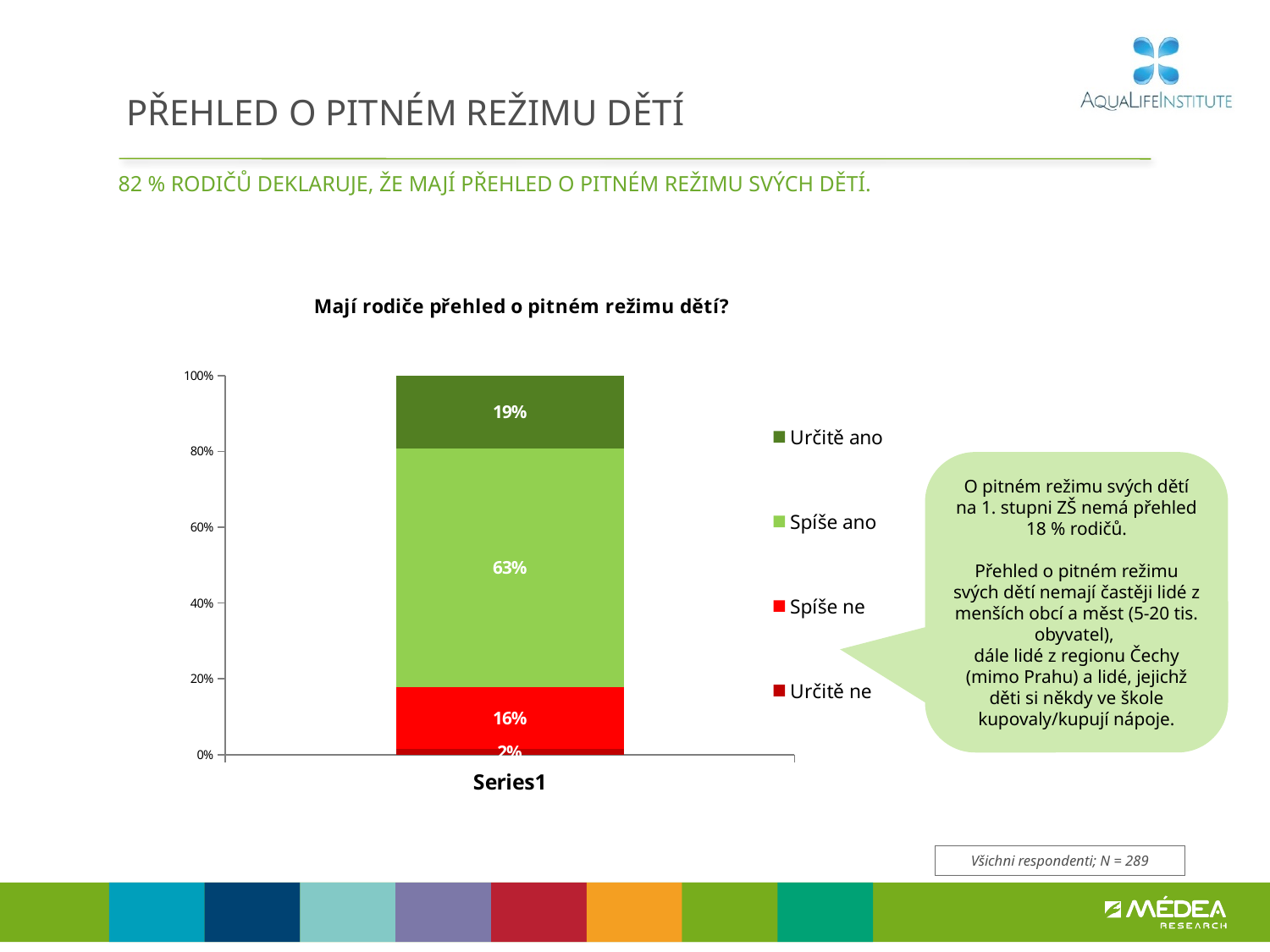
Which series has the largest share of the bar? Spíše ano How many series does the chart legend list? 4 What is the value for "Spíše ano"? 63% What is the value for "Určitě ne"? 2% What kind of chart is shown on the slide? Stacked bar chart What is the value for "Spíše ne"? 16% What is the title of the chart? Mají rodiče přehled o pitném režimu dětí? What is the difference between the values for "Spíše ano" and "Určitě ano"? 44% Which series has the smallest share of the bar? Určitě ne What is the combined value of "Určitě ano" and "Spíše ano"? 82% What is the value for "Určitě ano"? 19% Which is larger, the value for "Určitě ano" or the value for "Spíše ne"? Určitě ano